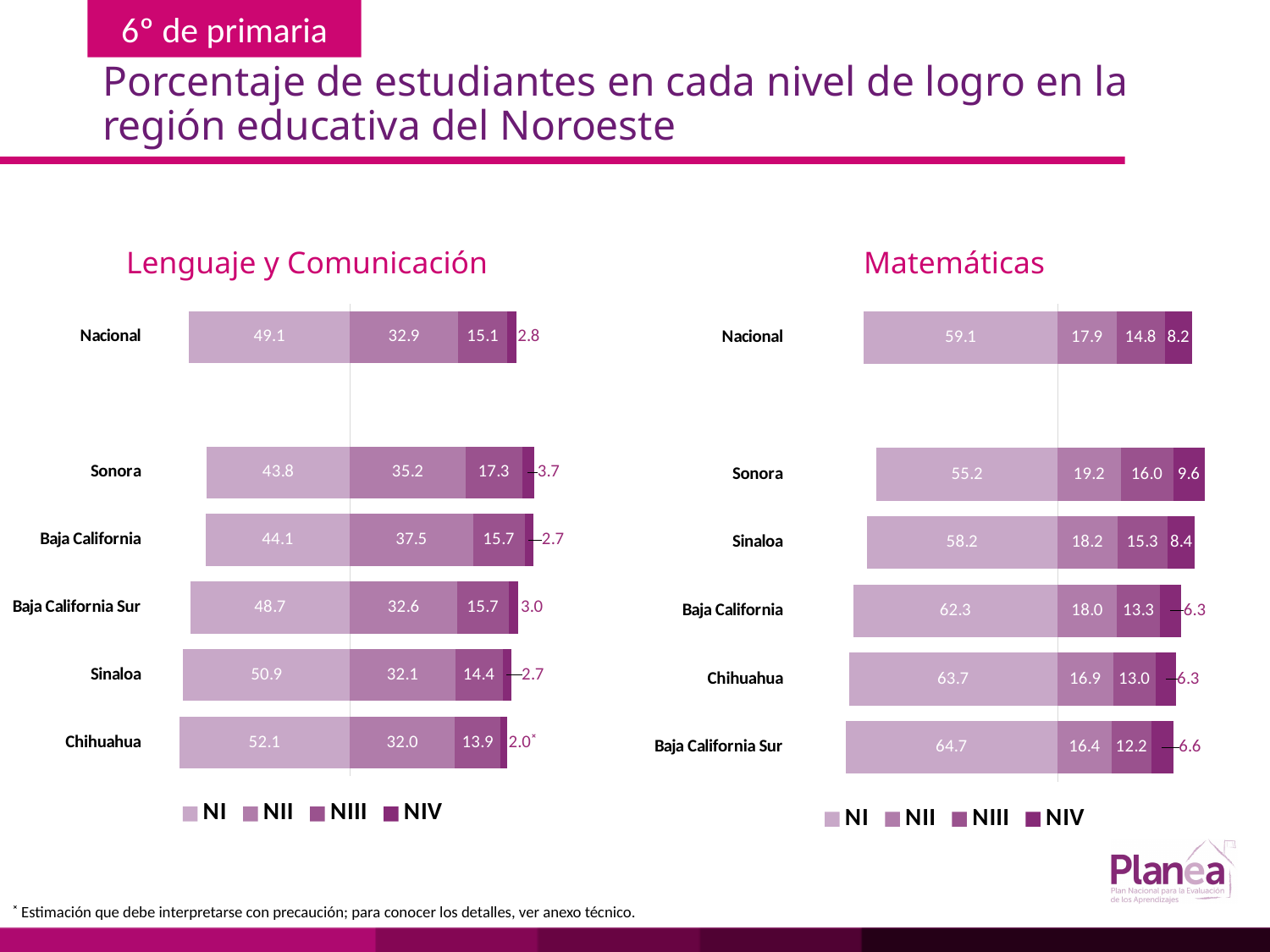
What type of chart is the Lenguaje y Comunicación chart? Stacked bar chart In the Matemáticas chart, what is the NII value for Nacional? 17.9 How many categories are shown in the Matemáticas chart? 6 How many series does the legend of the Lenguaje y Comunicación chart list? 4 What is the title of the chart on the right side of the slide? Matemáticas In the Matemáticas chart, what is the NIV value for Sonora? 9.6 In the Lenguaje y Comunicación chart, what is the difference between the NII values for Baja California and Chihuahua? 5.5 In the Lenguaje y Comunicación chart, which category has the highest NI value? Chihuahua In the Lenguaje y Comunicación chart, what is the NI value for Chihuahua? 52.1 In the Matemáticas chart, which category has the lowest NI value? Sonora In the Matemáticas chart, what is the total of the stacked bar for Sonora? 100.0 In the Matemáticas chart, which is larger: the NIII value for Sinaloa or the NIII value for Baja California Sur? Sinaloa